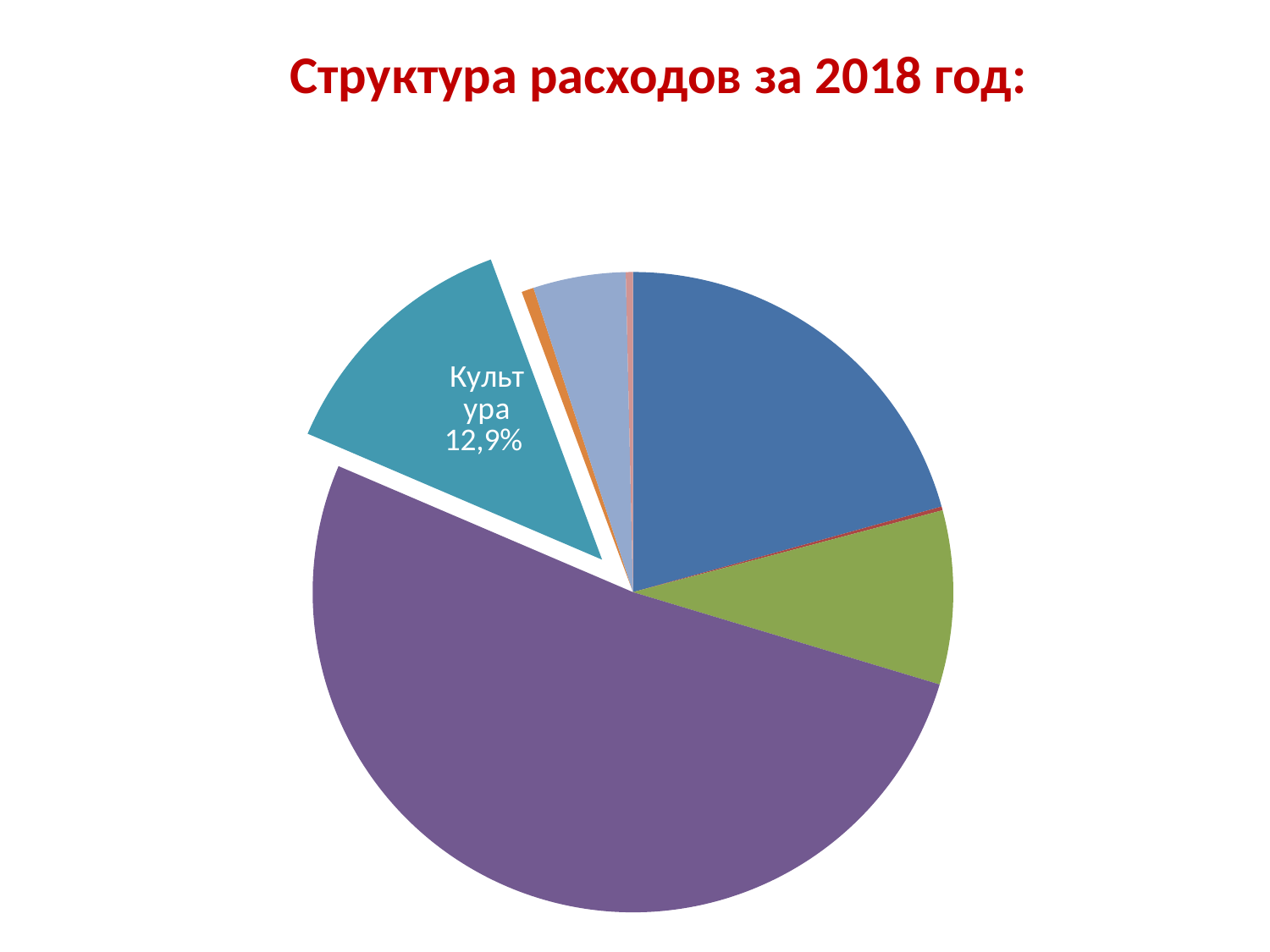
Which slice is pulled out (exploded) from the pie? Культура What percentage is printed on the Культура slice? 12,9% What kind of chart is shown on the slide? Pie chart Is the Культура slice the largest slice of the pie? No What share of expenses does the Культура slice represent? 12,9% What is the title of the chart? Структура расходов за 2018 год: